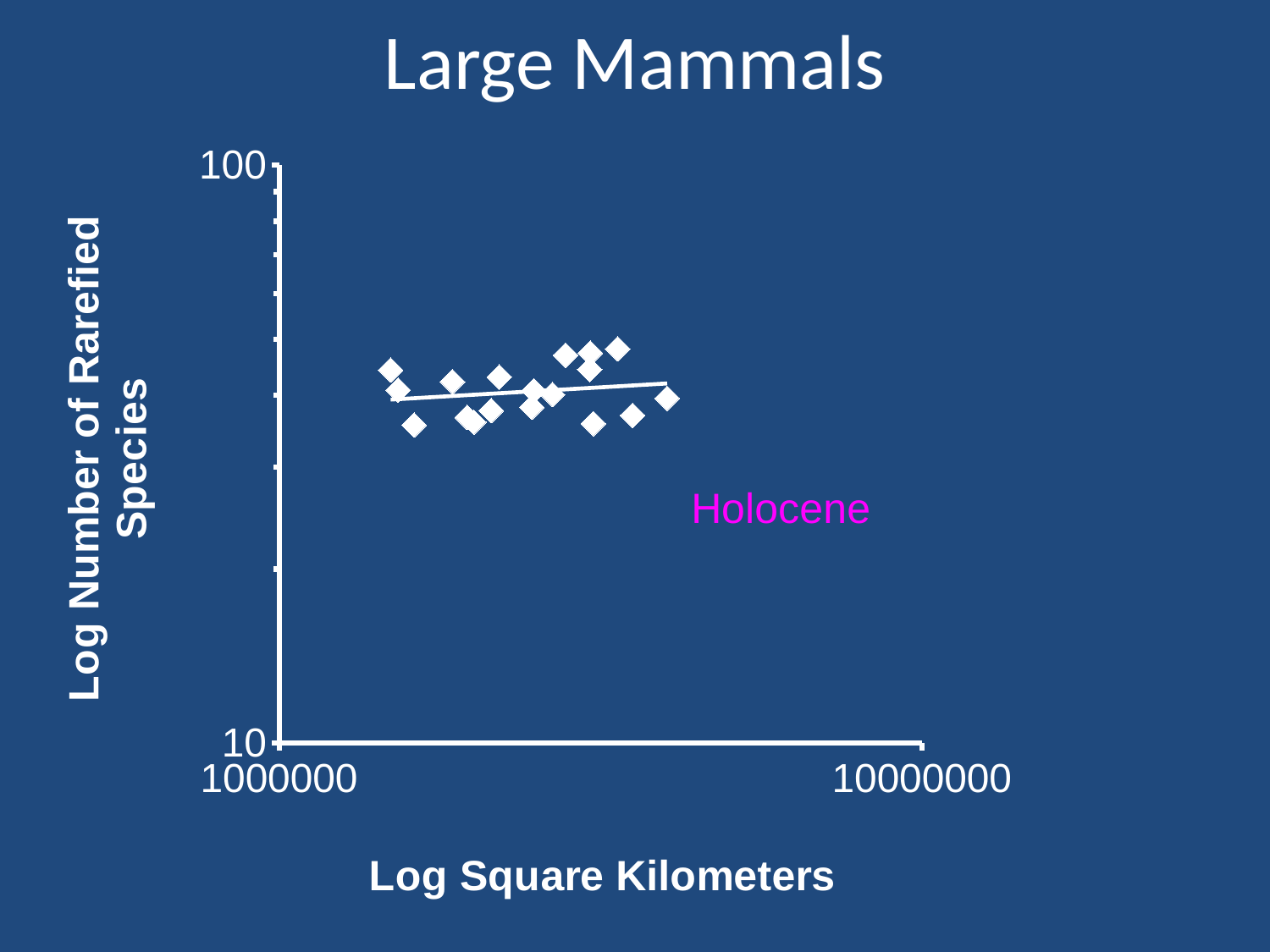
Are the plotted values for Log Number of Rarefied Species greater or less than 10? Greater What kind of chart is shown on the slide? Scatter chart Are the plotted values for Log Number of Rarefied Species greater or less than 100? Less Does the fitted line through the points rise or fall as Log Square Kilometers increases? Rises What text label is printed in magenta inside the plot area? Holocene Are the plotted points located at Log Square Kilometers values greater or less than 10000000? Less What is the title of the chart? Large Mammals